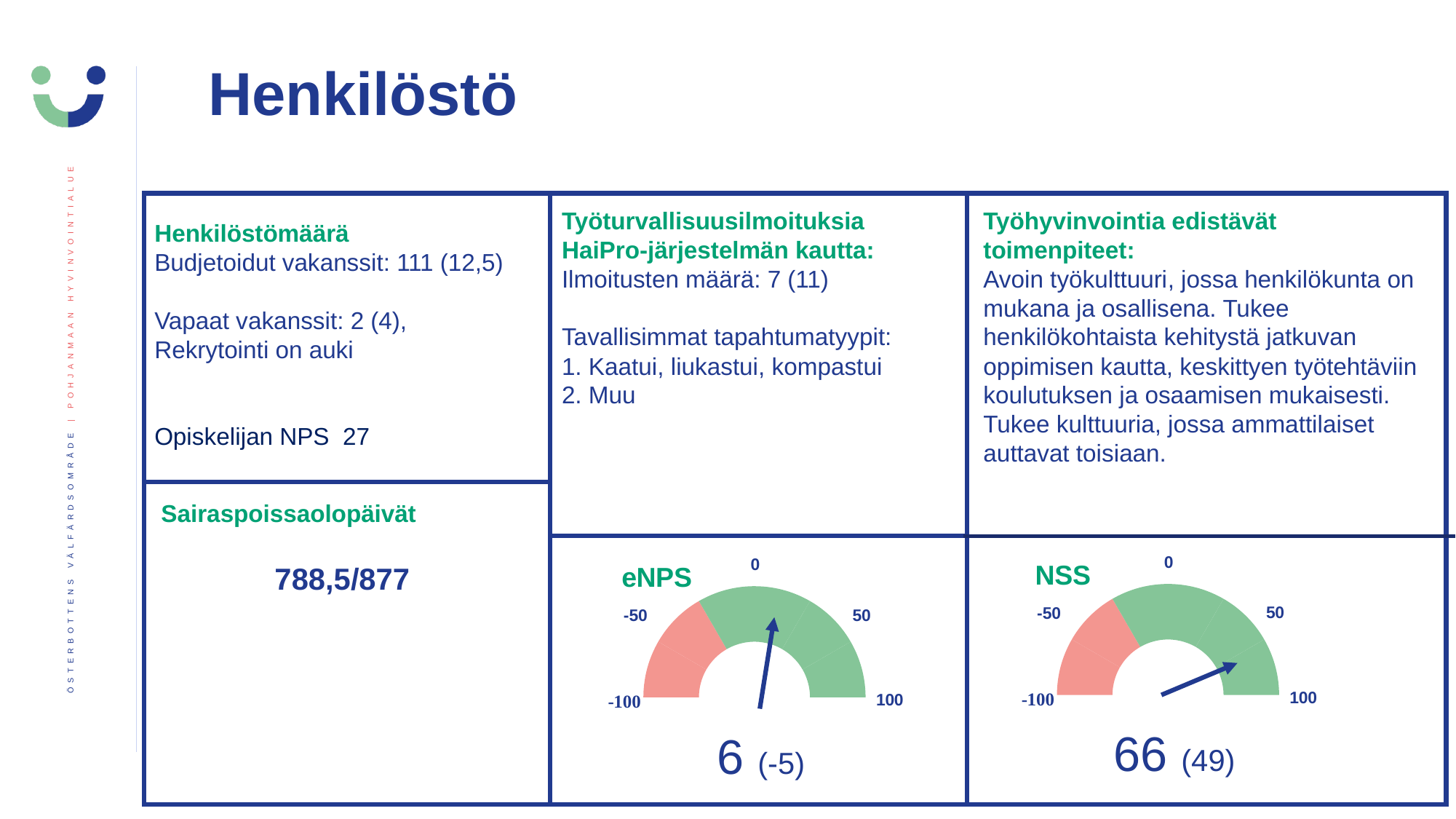
What is the difference between the current NSS value and the current eNPS value? 60 On the NSS gauge chart, what is the current value shown below the gauge? 66 On the eNPS gauge chart, what is the previous value shown in parentheses? -5 Which gauge chart shows the higher current value, eNPS or NSS? NSS On the eNPS gauge chart, what colour is the section of the scale between -100 and -50? Red On the eNPS gauge chart, what is the current value shown below the gauge? 6 What is the maximum value marked on the NSS gauge scale? 100 On the NSS gauge chart, what is the previous value shown in parentheses? 49 On the eNPS gauge chart, is the current value greater or less than 50? less What kind of chart is used to display the eNPS and NSS values? Gauge chart On the NSS gauge chart, is the current value greater or less than 50? greater On the NSS gauge chart, by how much did the value change from the previous value in parentheses to the current value? 17